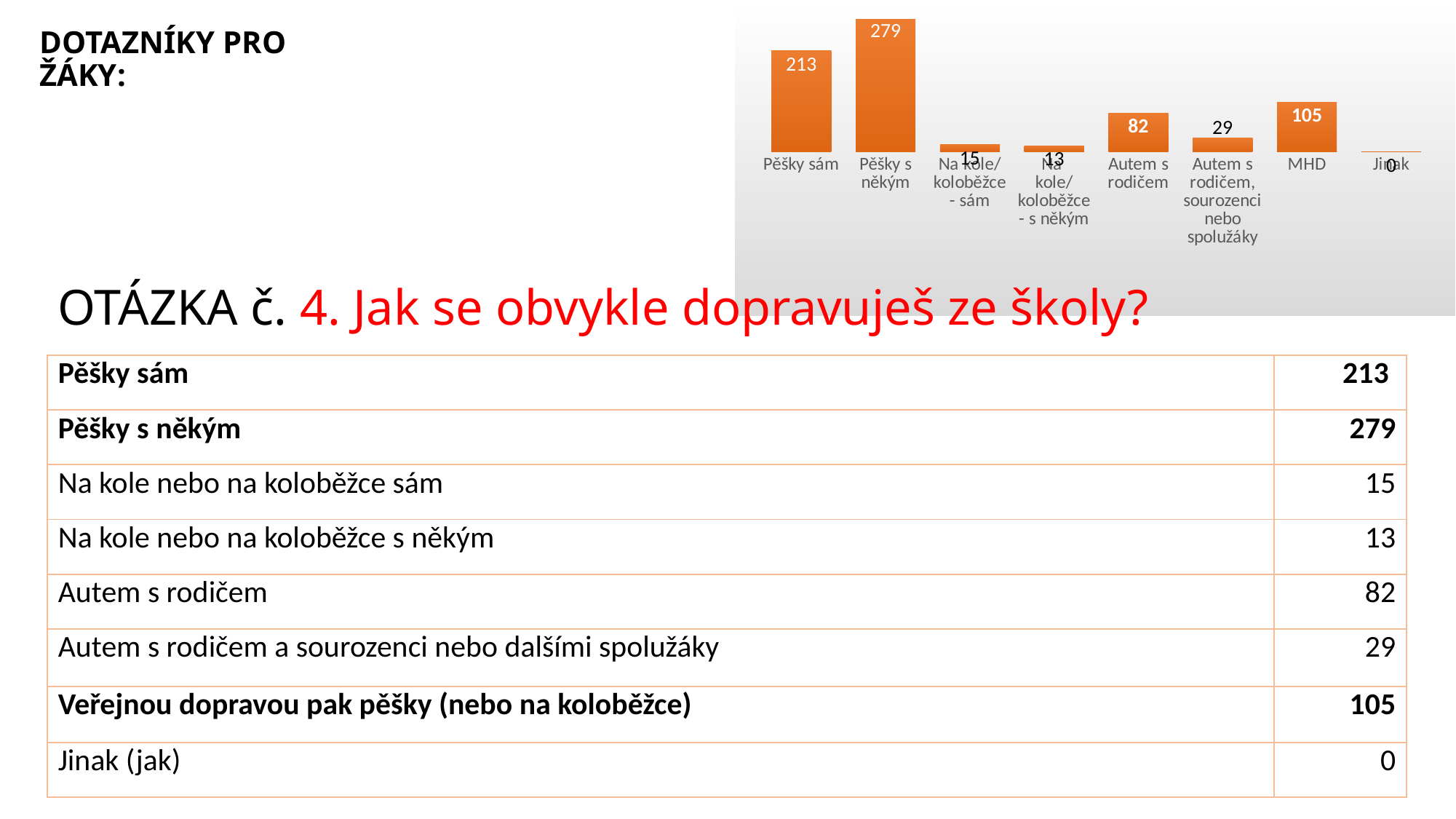
Which category has the highest value in the chart? Pěšky s někým Which category has the lowest value in the chart? Jinak What kind of chart is shown on the slide? bar chart What is the value for 'Pěšky sám' in the chart? 213 What is the value for 'Autem s rodičem' in the chart? 82 What is the value for 'MHD' in the chart? 105 What is the difference between 'Pěšky s někým' and 'Pěšky sám' in the chart? 66 What colour are the bars in the chart? orange What is the difference between 'Na kole/koloběžce - sám' and 'Na kole/koloběžce - s někým' in the chart? 2 Which is larger in the chart: 'Autem s rodičem' or 'MHD'? MHD How many categories are shown in the chart? 8 What is the value for 'Autem s rodičem, sourozenci nebo spolužáky' in the chart? 29